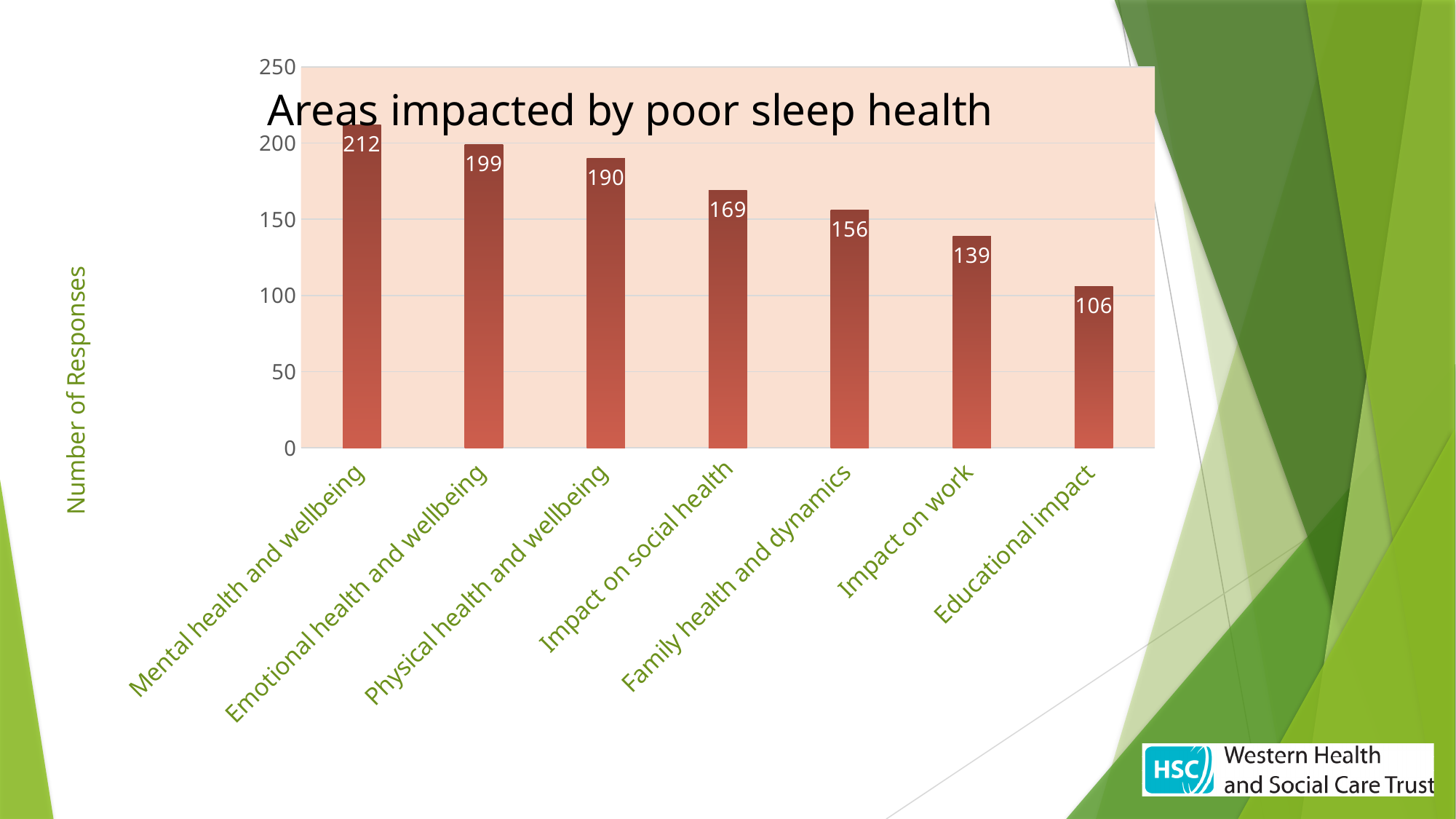
What is the number of responses for Impact on work? 139 Is the value for Educational impact greater or less than 150? less What is the difference in responses between Mental health and wellbeing and Educational impact? 106 What is the number of responses for Family health and dynamics? 156 Which area has the highest number of responses? Mental health and wellbeing What is the title of the chart? Areas impacted by poor sleep health Which has more responses, Impact on social health or Impact on work? Impact on social health Which area has the lowest number of responses? Educational impact How many areas are shown in the chart? 7 What kind of chart is shown on the slide? Bar chart What is the number of responses for Mental health and wellbeing? 212 What is the difference in responses between Emotional health and wellbeing and Physical health and wellbeing? 9